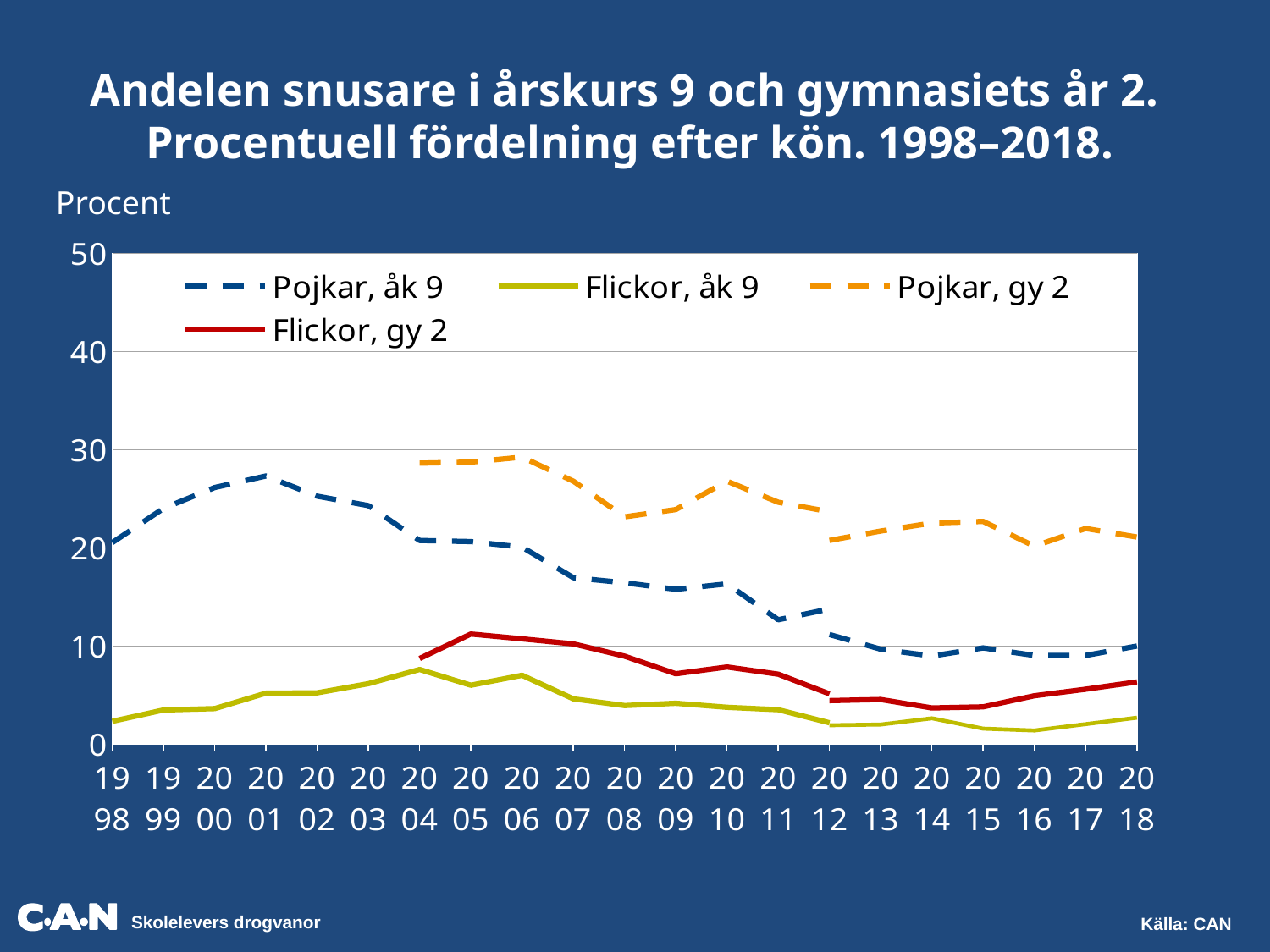
Is the value for Pojkar, åk 9 in 2012 greater or less than 10? greater How many years are shown along the x axis? 21 Is the value for Pojkar, gy 2 in 2004 greater or less than 20? greater Is the value for Pojkar, åk 9 in 2001 greater or less than 20? greater Which series has the highest value in 2006? Pojkar, gy 2 How many series does the legend list? 4 What kind of chart is shown on the slide? line chart In 2018, which is higher: Pojkar, gy 2 or Pojkar, åk 9? Pojkar, gy 2 Which series has the lowest value in 2016? Flickor, åk 9 Does the value for Pojkar, åk 9 rise or fall overall from 2001 to 2018? fall